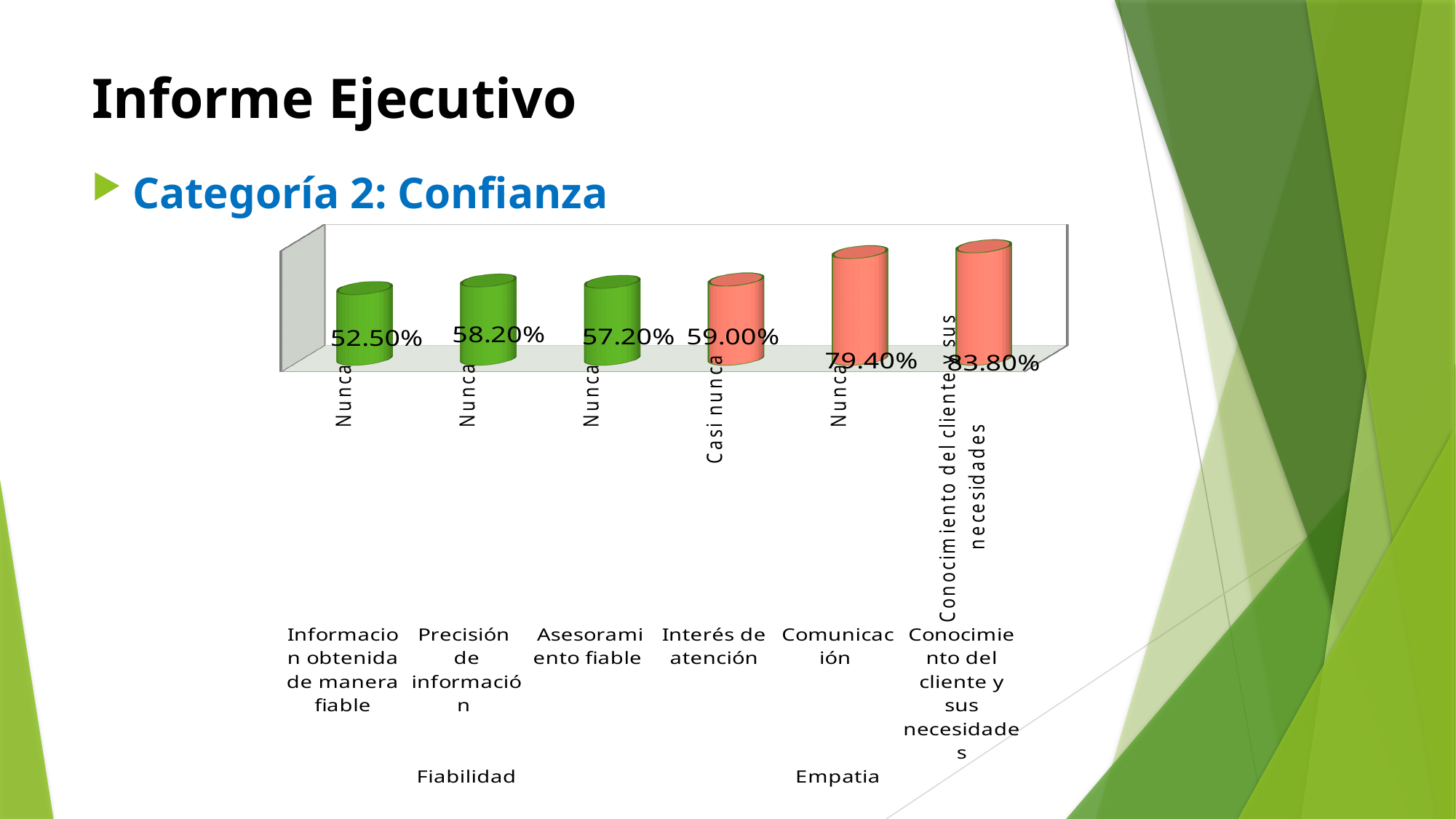
Which category has the highest value? Conocimiento del cliente y sus necesidades What is the value for Comunicación? 79.40% What is the value for Asesoramiento fiable? 57.20% How many categories are plotted in the chart? 6 Which two group labels appear below the category labels of the chart? Fiabilidad and Empatia Which category has the lowest value? Información obtenida de manera fiable What is the difference between the values for Precisión de información and Información obtenida de manera fiable? 5.70% What kind of chart is shown on the slide? Bar chart Which is larger, the value for Comunicación or the value for Interés de atención? Comunicación What is the difference between the values for Conocimiento del cliente y sus necesidades and Comunicación? 4.40% What is the value for Precisión de información? 58.20% What is the value for Interés de atención? 59.00%